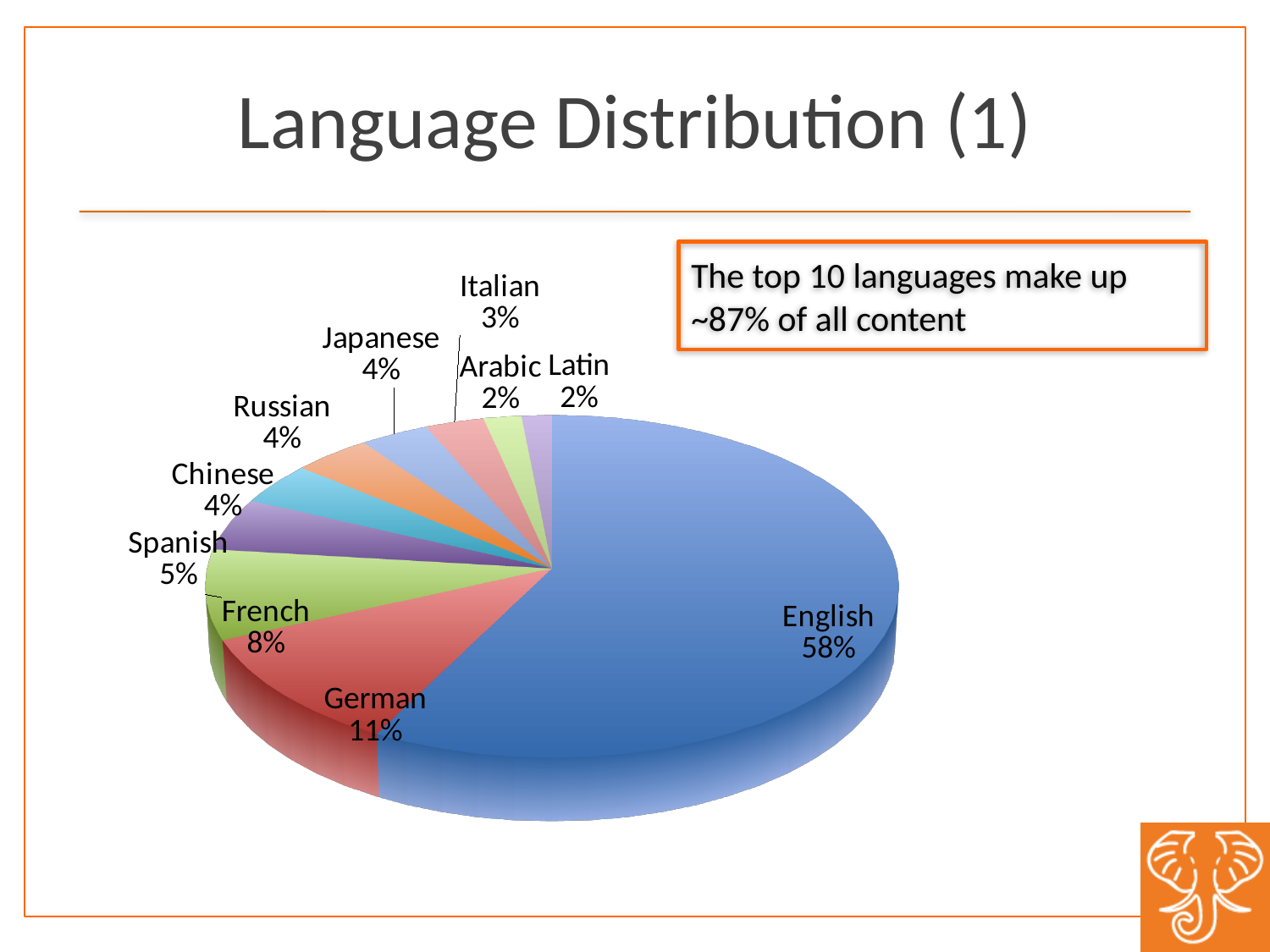
What percentage is shown for French? 8% What is the difference in percentage points between English and German? 47 Which language has the largest slice of the pie? English How many language slices are labelled on the pie chart? 10 According to the text box, what share of all content do the top 10 languages make up? ~87% What share of the pie does English account for? 58% What percentage is shown for Spanish? 5% What is the title of the slide? Language Distribution (1) Which is larger, the share for French or the share for Spanish? French What percentage is shown for Italian? 3% What percentage is shown for German? 11% What kind of chart is shown on the slide? Pie chart